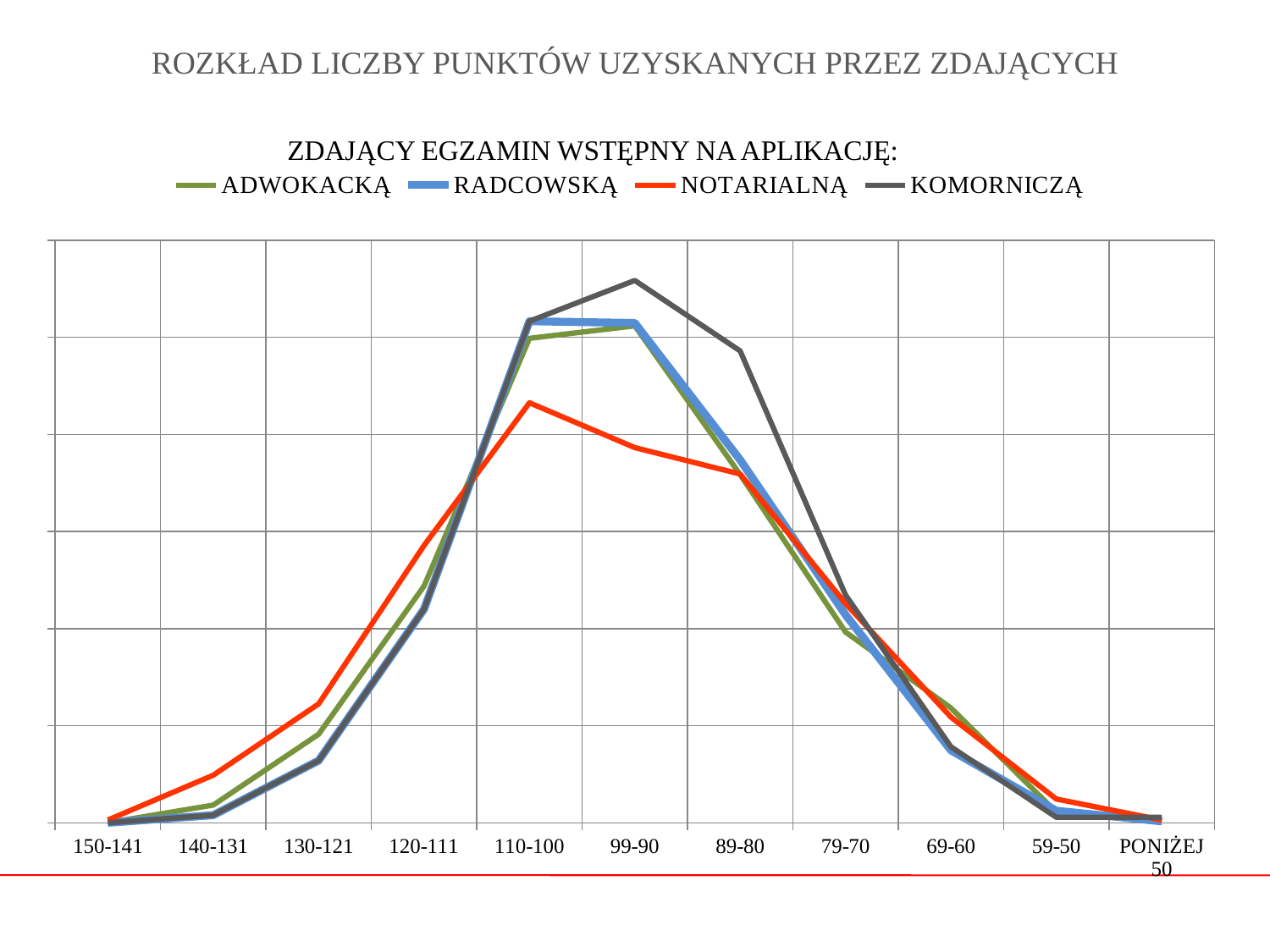
At 89-80, which is higher: KOMORNICZĄ or ADWOKACKĄ? KOMORNICZĄ In which point range does the KOMORNICZĄ series reach its highest value? 99-90 How many point-range categories are shown on the x axis? 11 Which series has the lowest peak on the chart? NOTARIALNĄ Does the KOMORNICZĄ series rise or fall from 99-90 to PONIŻEJ 50? fall At 99-90, which is higher: KOMORNICZĄ or NOTARIALNĄ? KOMORNICZĄ Which series reaches the highest peak on the chart? KOMORNICZĄ In which point range does the NOTARIALNĄ series reach its highest value? 110-100 At 120-111, which is higher: NOTARIALNĄ or KOMORNICZĄ? NOTARIALNĄ What kind of chart is shown on the slide? line chart How many series does the legend list? 4 Which colour is used for the NOTARIALNĄ series? red